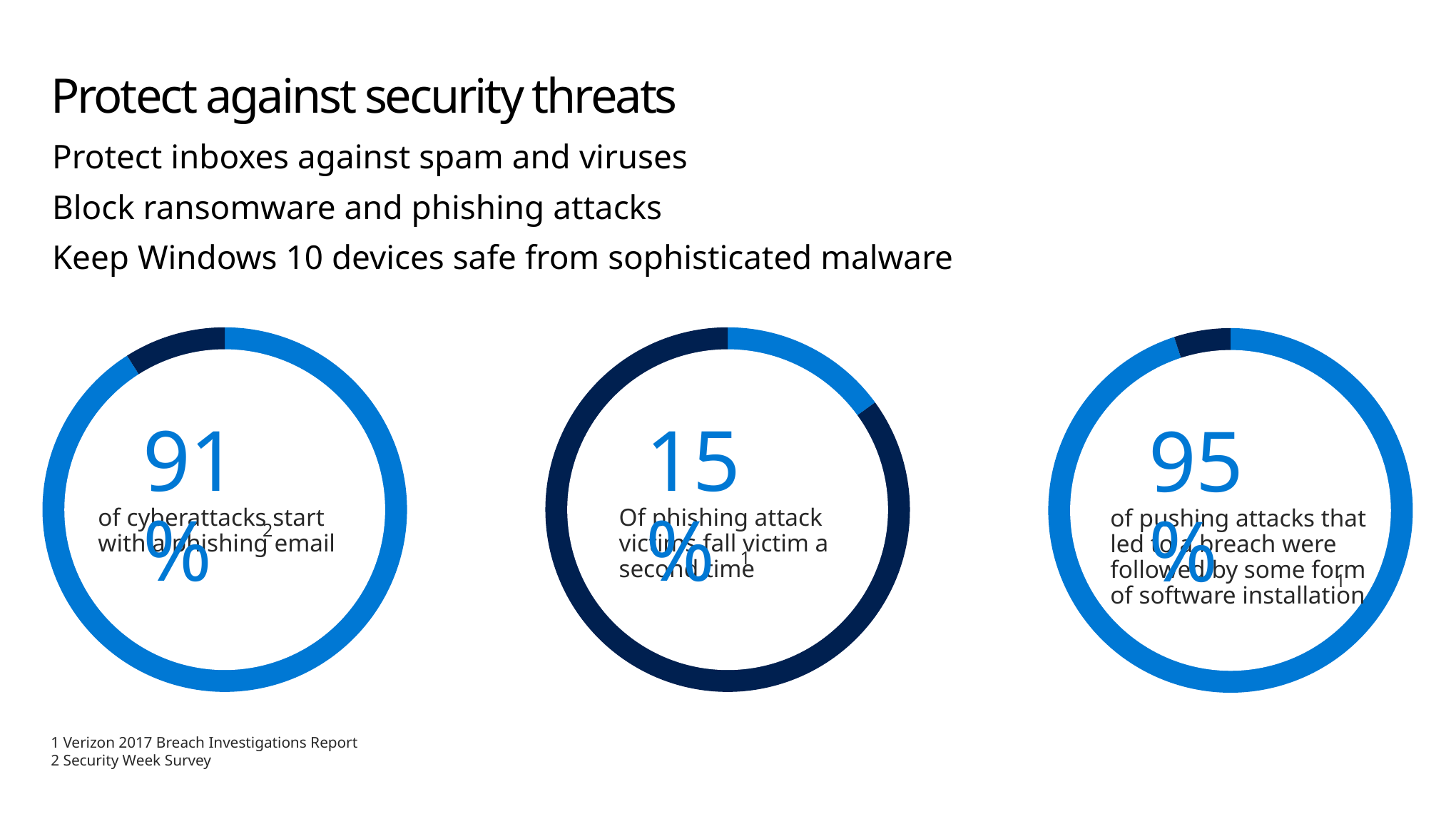
Is the percentage in the left donut chart larger or smaller than the percentage in the middle donut chart? Larger Which of the three donut charts shows the lowest percentage? The middle chart (15%) What percentage is shown in the left donut chart about cyberattacks starting with a phishing email? 91% What is the title of the slide containing the three donut charts? Protect against security threats What kind of chart is used to display the three statistics on the slide? Donut chart What is the difference between the percentage in the right donut chart and the percentage in the left donut chart? 4 percentage points How many donut charts are shown on the slide? 3 What percentage is shown in the right donut chart about phishing attacks that led to a breach being followed by software installation? 95% What percentage is shown in the middle donut chart about phishing attack victims falling victim a second time? 15% In the middle donut chart, is the highlighted light-blue portion greater or less than 50% of the ring? less Which of the three donut charts shows the highest percentage? The right chart (95%) What is the difference between the percentage in the left donut chart and the percentage in the middle donut chart? 76 percentage points